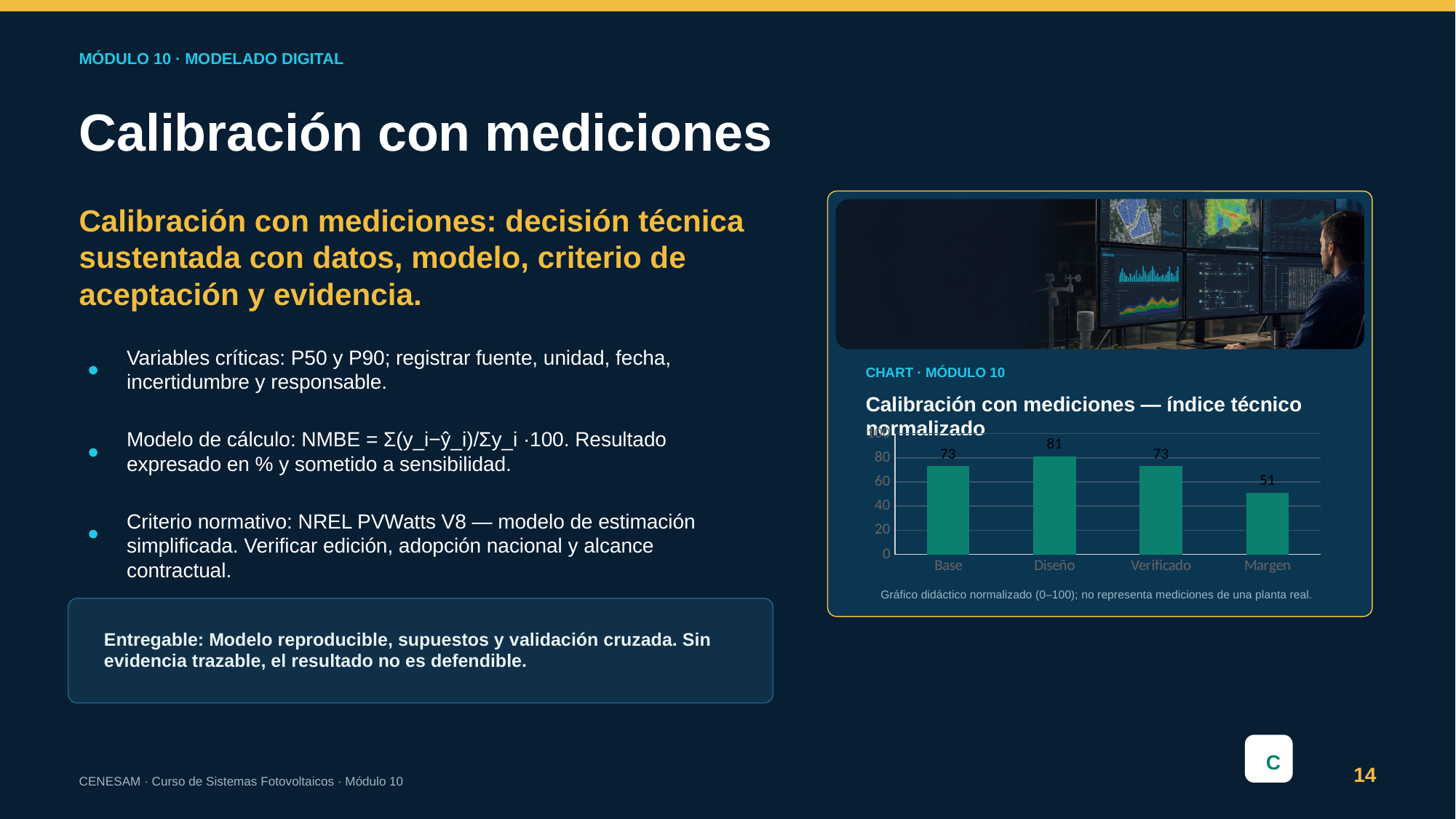
What is the difference between the values for Diseño and Margen? 30 What is the value for Base? 73 What is the value for Diseño? 81 How many categories are shown on the x axis? 4 What is the title of the chart? Calibración con mediciones — índice técnico normalizado What is the value for Margen? 51 What kind of chart is shown on the slide? Bar chart What is the value for Verificado? 73 What is the difference between the values for Diseño and Base? 8 Which category has the highest value? Diseño Which is larger, the value for Verificado or the value for Margen? Verificado Which category has the lowest value? Margen